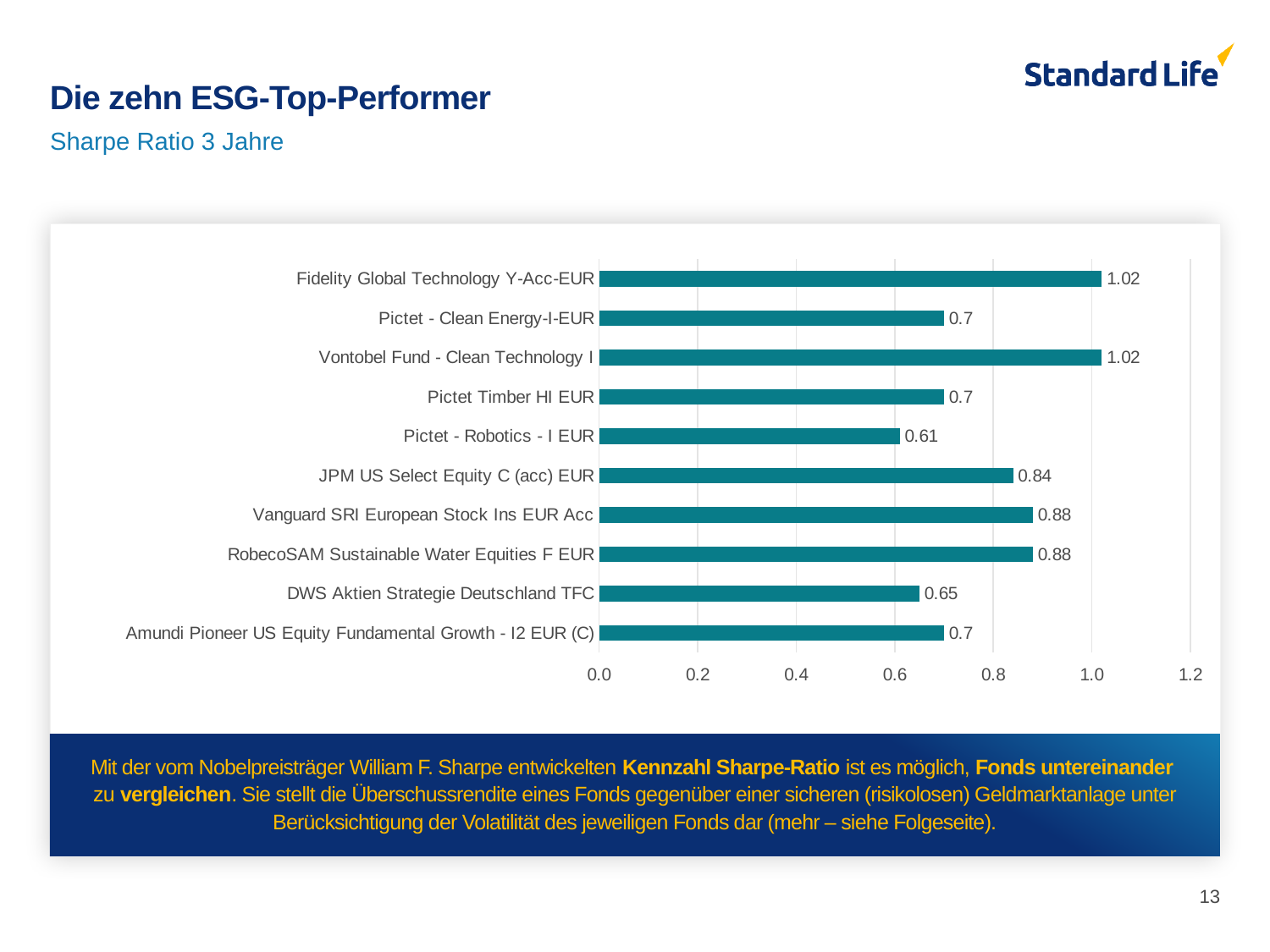
How many funds are shown in the chart? 10 What is the value shown for JPM US Select Equity C (acc) EUR? 0.84 What kind of chart is shown on the slide? bar chart What is the Sharpe Ratio value for Fidelity Global Technology Y-Acc-EUR? 1.02 Which has a higher value: JPM US Select Equity C (acc) EUR or RobecoSAM Sustainable Water Equities F EUR? RobecoSAM Sustainable Water Equities F EUR What is the subtitle of the chart on the slide? Sharpe Ratio 3 Jahre Is the value for Pictet - Robotics - I EUR greater or less than 0.8? less What is the difference between the values for Vontobel Fund - Clean Technology I and Pictet - Clean Energy-I-EUR? 0.32 What is the difference between the values for Vanguard SRI European Stock Ins EUR Acc and DWS Aktien Strategie Deutschland TFC? 0.23 What is the value shown for DWS Aktien Strategie Deutschland TFC? 0.65 What is the value shown for Pictet Timber HI EUR? 0.7 Which fund has the lowest Sharpe Ratio in the chart? Pictet - Robotics - I EUR